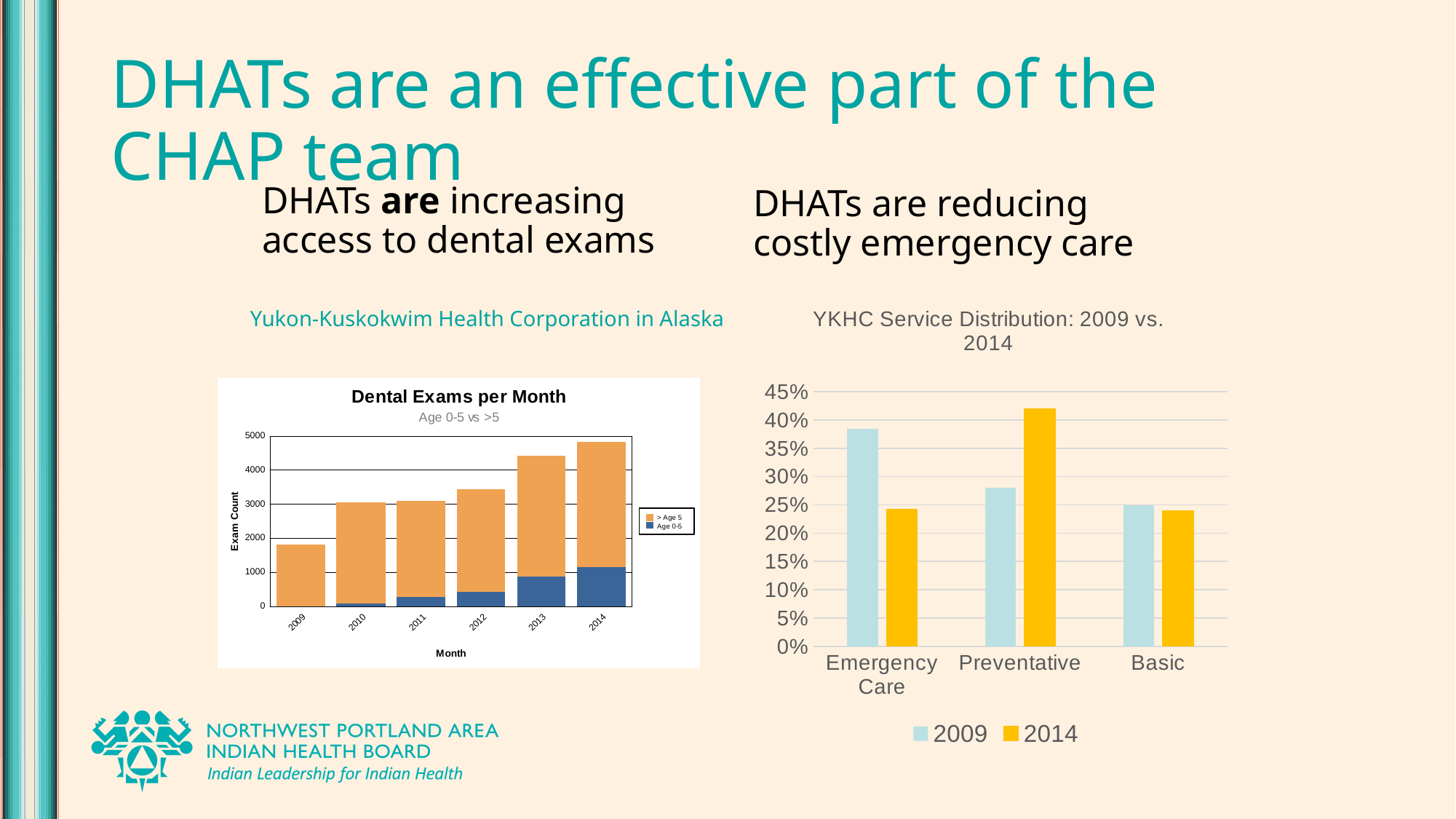
In the Dental Exams per Month chart, is the total exam count for 2009 greater or less than 2000? less In the YKHC Service Distribution chart, which is larger for Preventative, the 2009 value or the 2014 value? 2014 In the Dental Exams per Month chart, which year has the highest total exam count? 2014 In the YKHC Service Distribution chart, which category has the highest value for 2009? Emergency Care In the YKHC Service Distribution chart, which category has the highest value for 2014? Preventative In the Dental Exams per Month chart, how many years are shown on the x axis? 6 In the Dental Exams per Month chart, do total exam counts generally rise or fall from 2009 to 2014? rise In the Dental Exams per Month chart, what kind of chart is it? bar chart In the Dental Exams per Month chart, which year has the lowest total exam count? 2009 In the YKHC Service Distribution chart, is the 2009 value for Emergency Care greater or less than 35%? greater In the Dental Exams per Month chart, is the total exam count for 2013 greater or less than 4000? greater In the Dental Exams per Month chart, how many series does the legend list? 2